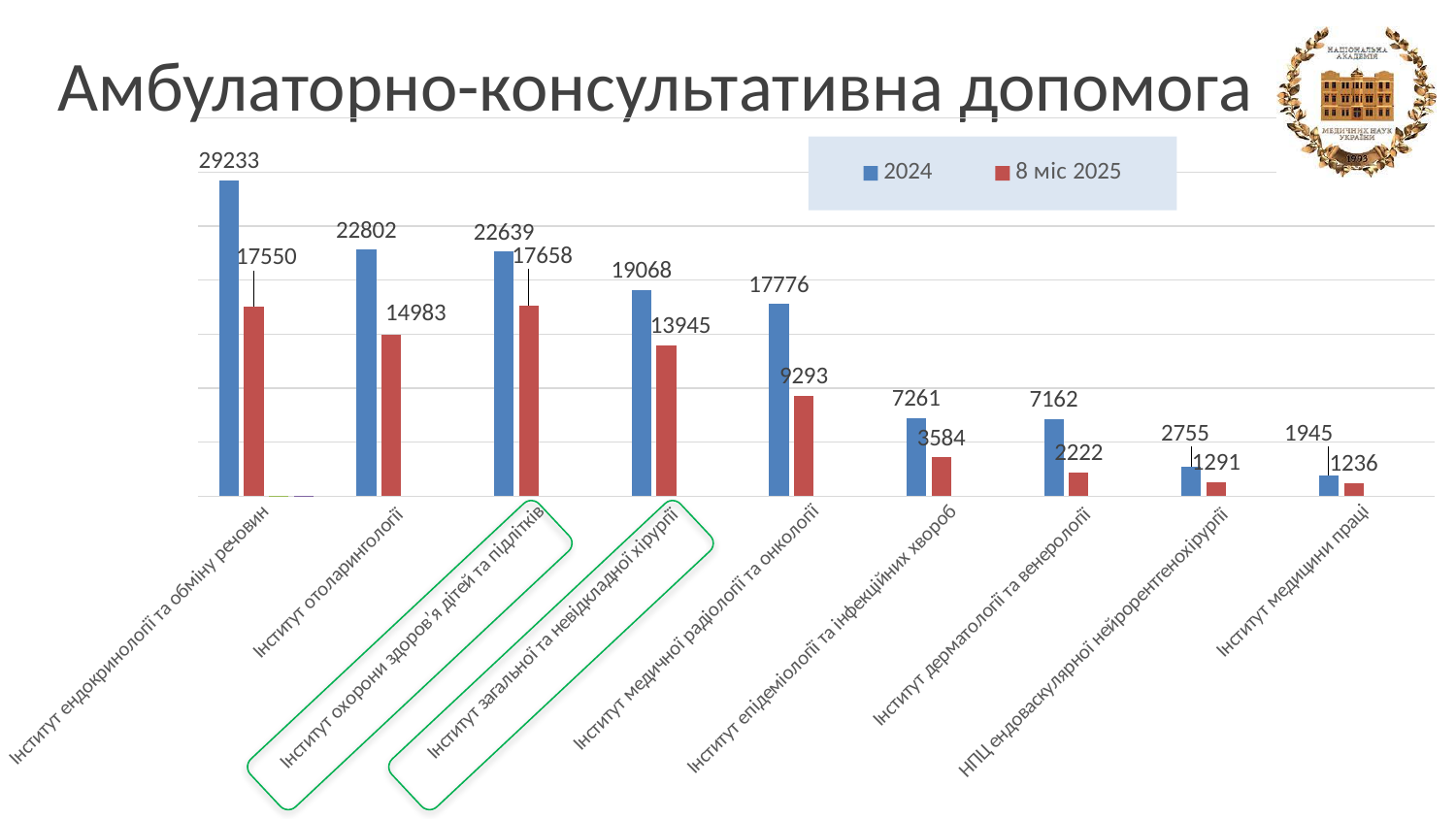
How many institutes (categories) are shown on the x axis? 9 Which institute has the highest 2024 value? Інститут ендокринології та обміну речовин What is the difference between the 2024 and 8 міс 2025 values for Інститут ендокринології та обміну речовин? 11683 What is the 8 міс 2025 value for Інститут медичної радіології та онкології? 9293 Which is larger: the 8 міс 2025 value for Інститут отоларингології or for Інститут загальної та невідкладної хірургії? Інститут отоларингології What is the 2024 value for НПЦ ендоваскулярної нейрорентгенохірургії? 2755 What is the 2024 value for Інститут ендокринології та обміну речовин? 29233 What is the difference between the 2024 and 8 міс 2025 values for Інститут охорони здоров'я дітей та підлітків? 4981 What is the title of the chart on the slide? Амбулаторно-консультативна допомога What type of chart is shown on the slide? bar chart How many series does the legend list? 2 Which institute has the lowest 2024 value? Інститут медицини праці